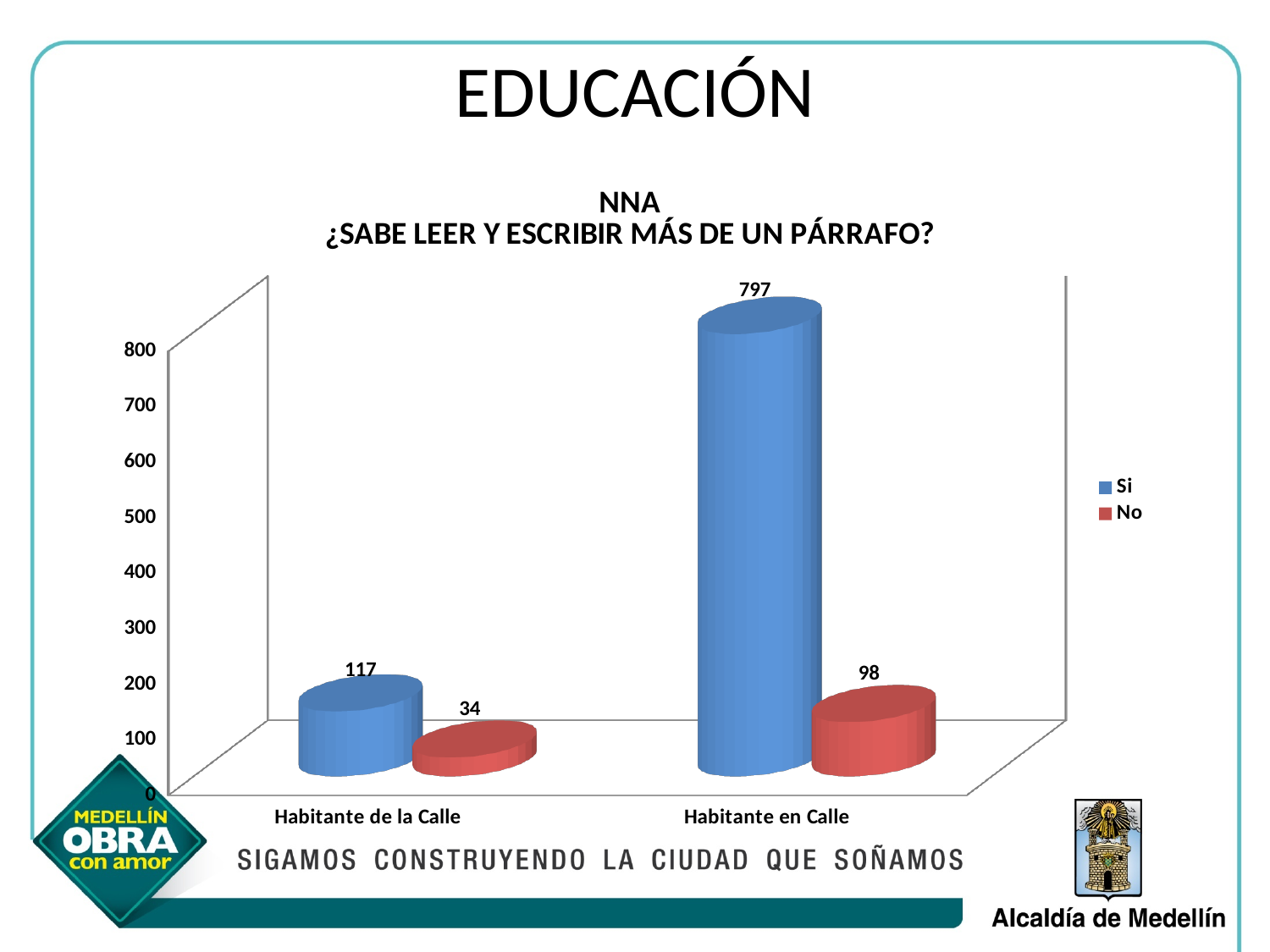
What is the title of the chart? NNA ¿SABE LEER Y ESCRIBIR MÁS DE UN PÁRRAFO? What kind of chart is shown on the slide? Bar chart What is the value for "Si" for Habitante en Calle? 797 How many series does the legend list? 2 What is the value for "Si" for Habitante de la Calle? 117 What is the value for "No" for Habitante de la Calle? 34 How many categories are shown on the x axis? 2 Which is larger for Habitante en Calle: "Si" or "No"? Si What is the difference between the "Si" values for Habitante en Calle and Habitante de la Calle? 680 Which category has the highest "Si" value? Habitante en Calle Which category has the lowest "No" value? Habitante de la Calle What is the value for "No" for Habitante en Calle? 98